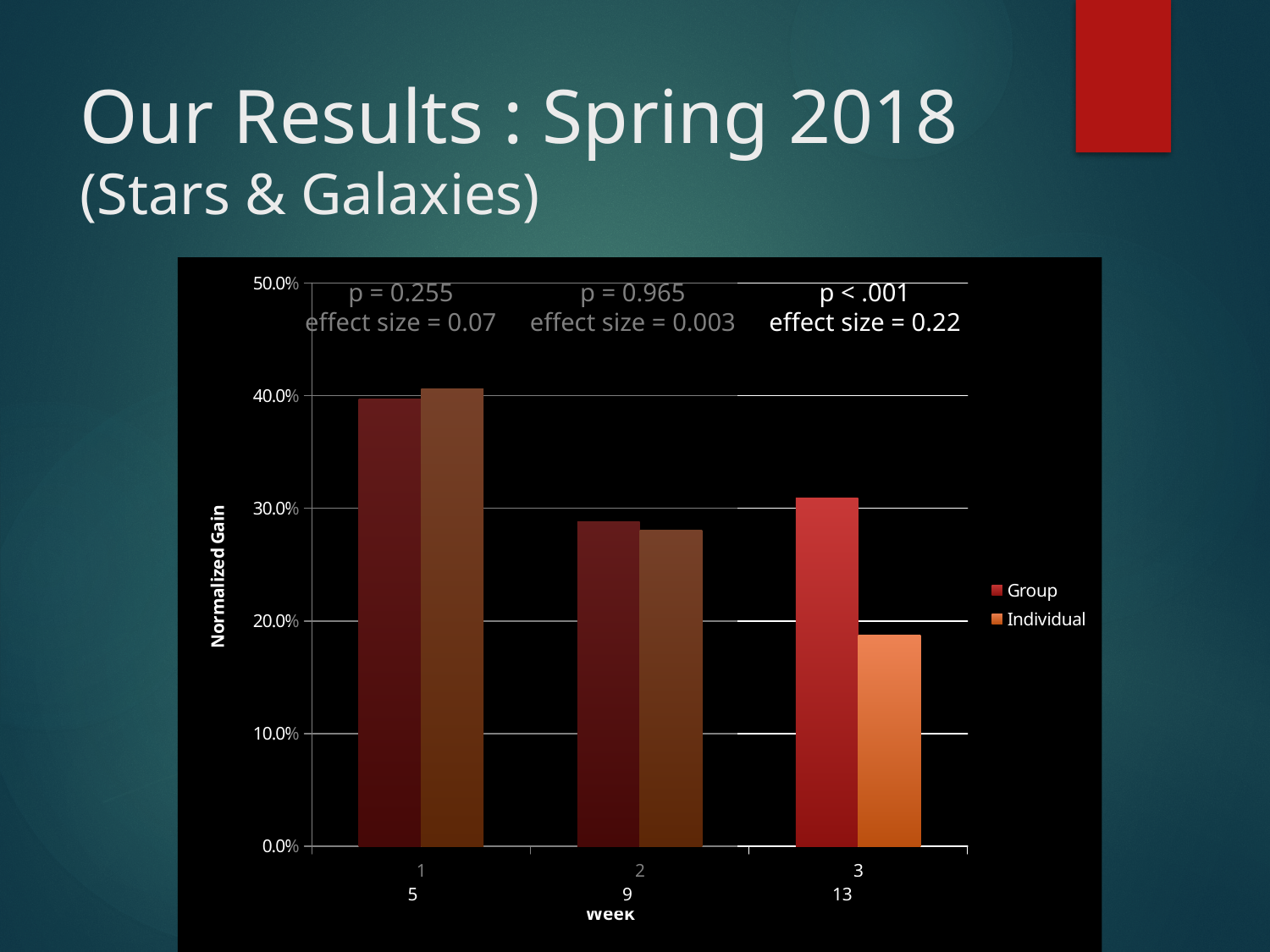
At which week is the Individual series lowest? 13 What is the title of the vertical axis? Normalized Gain Do the Individual values rise or fall from week 5 to week 13? fall Which series has the larger value at week 13, Group or Individual? Group What kind of chart is shown on the slide? bar chart Is the value for Group at week 5 greater or less than 30.0%? greater How many week categories are plotted on the x axis? 3 Is the value for Individual at week 9 greater or less than 30.0%? less At which week is the Individual series highest? 5 Is the value for Individual at week 13 greater or less than 30.0%? less How many series does the legend list? 2 At which week is the Group series lowest? 9